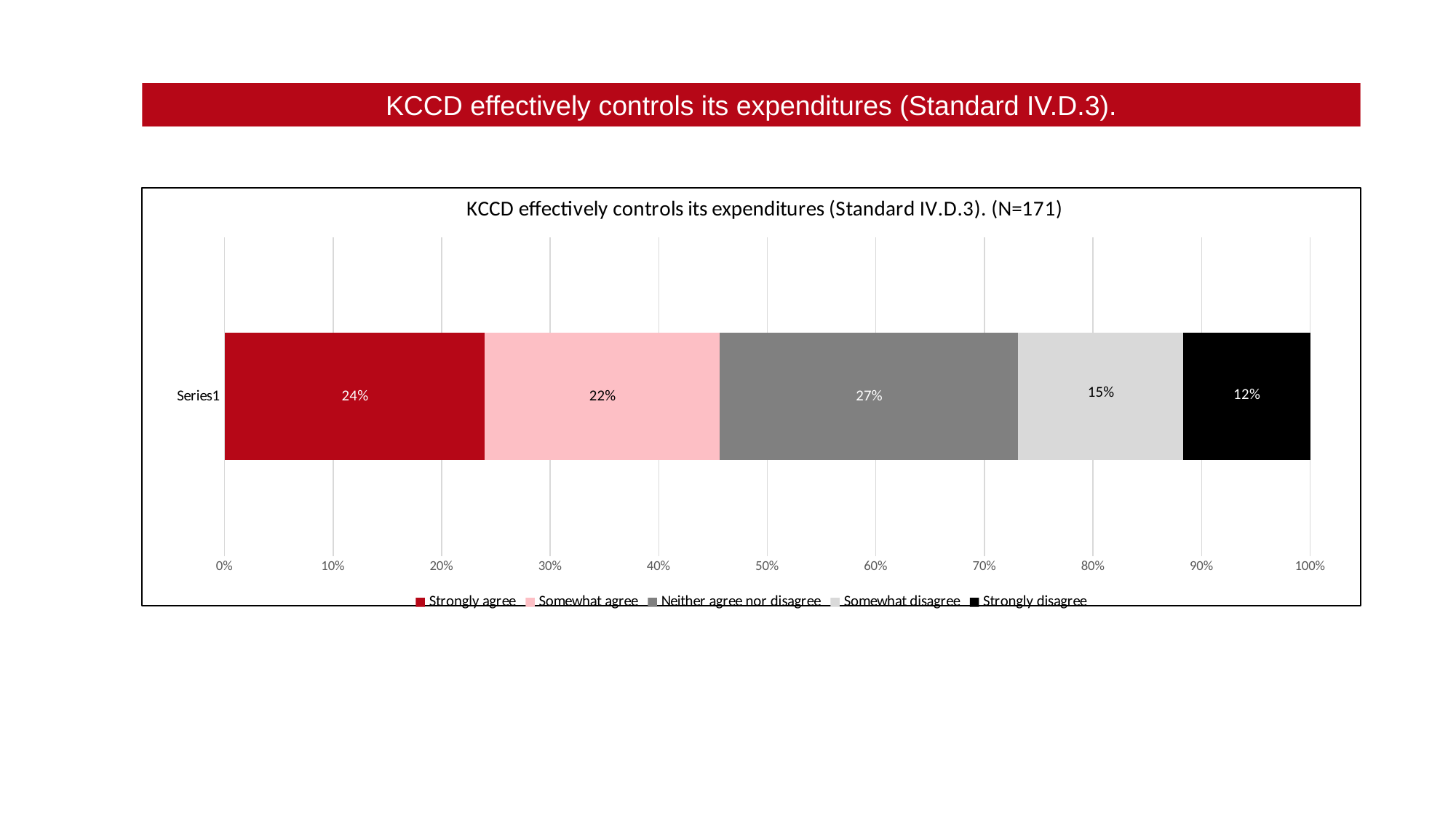
Which is larger, the share for "Somewhat agree" or the share for "Somewhat disagree"? Somewhat agree Which response category has the smallest share? Strongly disagree What percentage of respondents selected "Strongly disagree"? 12% What is the sample size (N) stated in the chart title? 171 What percentage of respondents selected "Neither agree nor disagree"? 27% How many series does the legend list? 5 What percentage of respondents selected "Somewhat agree"? 22% What percentage of respondents selected "Somewhat disagree"? 15% What percentage of respondents selected "Strongly agree"? 24% What is the difference in percentage points between "Strongly agree" and "Strongly disagree"? 12 Which response category has the largest share? Neither agree nor disagree What kind of chart is shown on the slide? Stacked bar chart